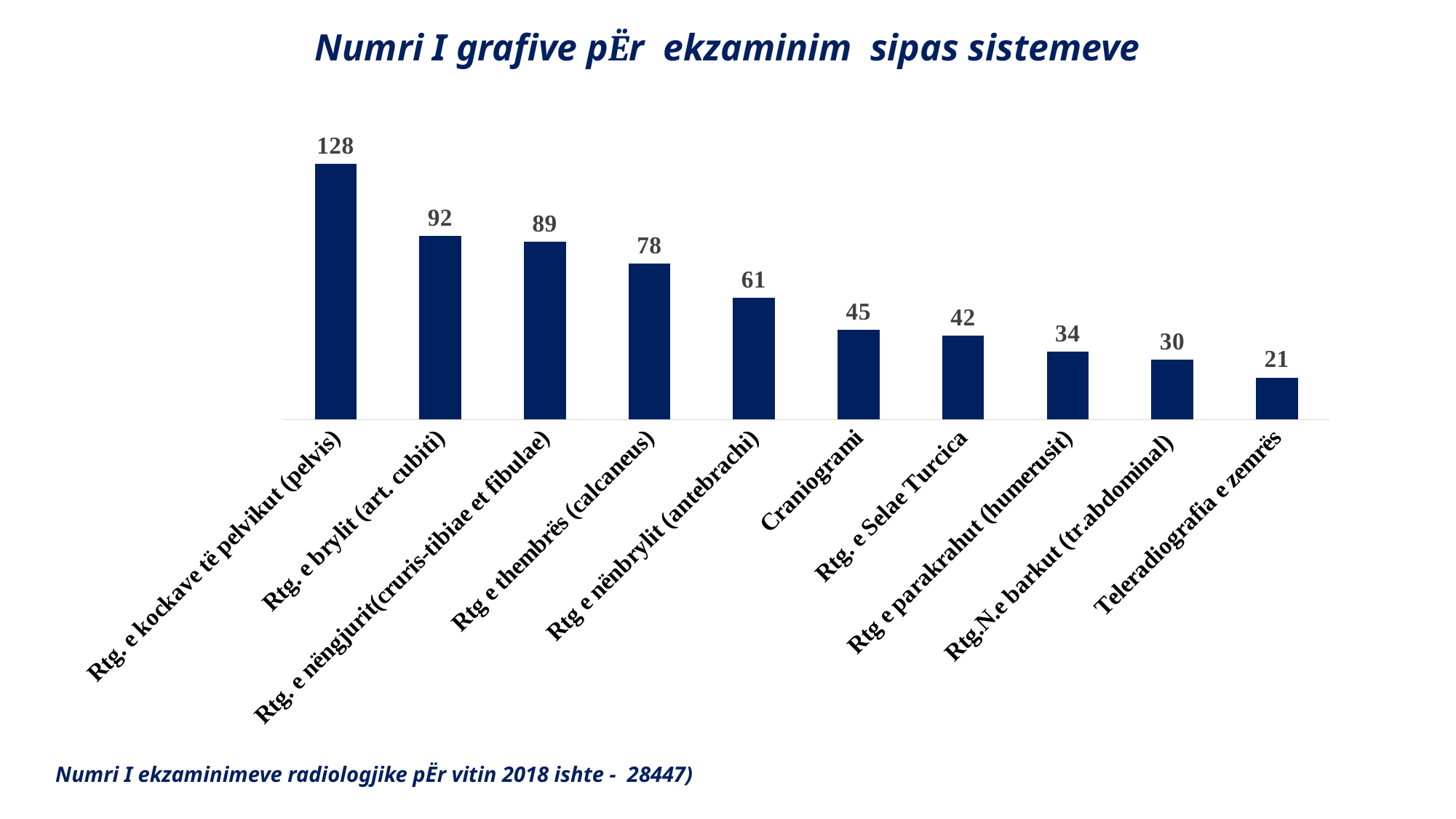
What is the title of the chart? Numri I grafive pËr ekzaminim sipas sistemeve What is the difference between the values for Rtg. e kockave të pelvikut (pelvis) and Rtg. e brylit (art. cubiti)? 36 Which is larger, the value for Rtg. e Selae Turcica or the value for Rtg e parakrahut (humerusit)? Rtg. e Selae Turcica What is the difference between the values for Rtg e thembrës (calcaneus) and Rtg e nënbrylit (antebrachi)? 17 Which category has the highest value? Rtg. e kockave të pelvikut (pelvis) What is the value for Rtg. e brylit (art. cubiti)? 92 Which category has the lowest value? Teleradiografia e zemrës What is the value for Craniogrami? 45 What kind of chart is shown on the slide? Bar chart How many categories are shown in the chart? 10 Do the values rise or fall from left to right along the x axis? Fall What is the value for Teleradiografia e zemrës? 21